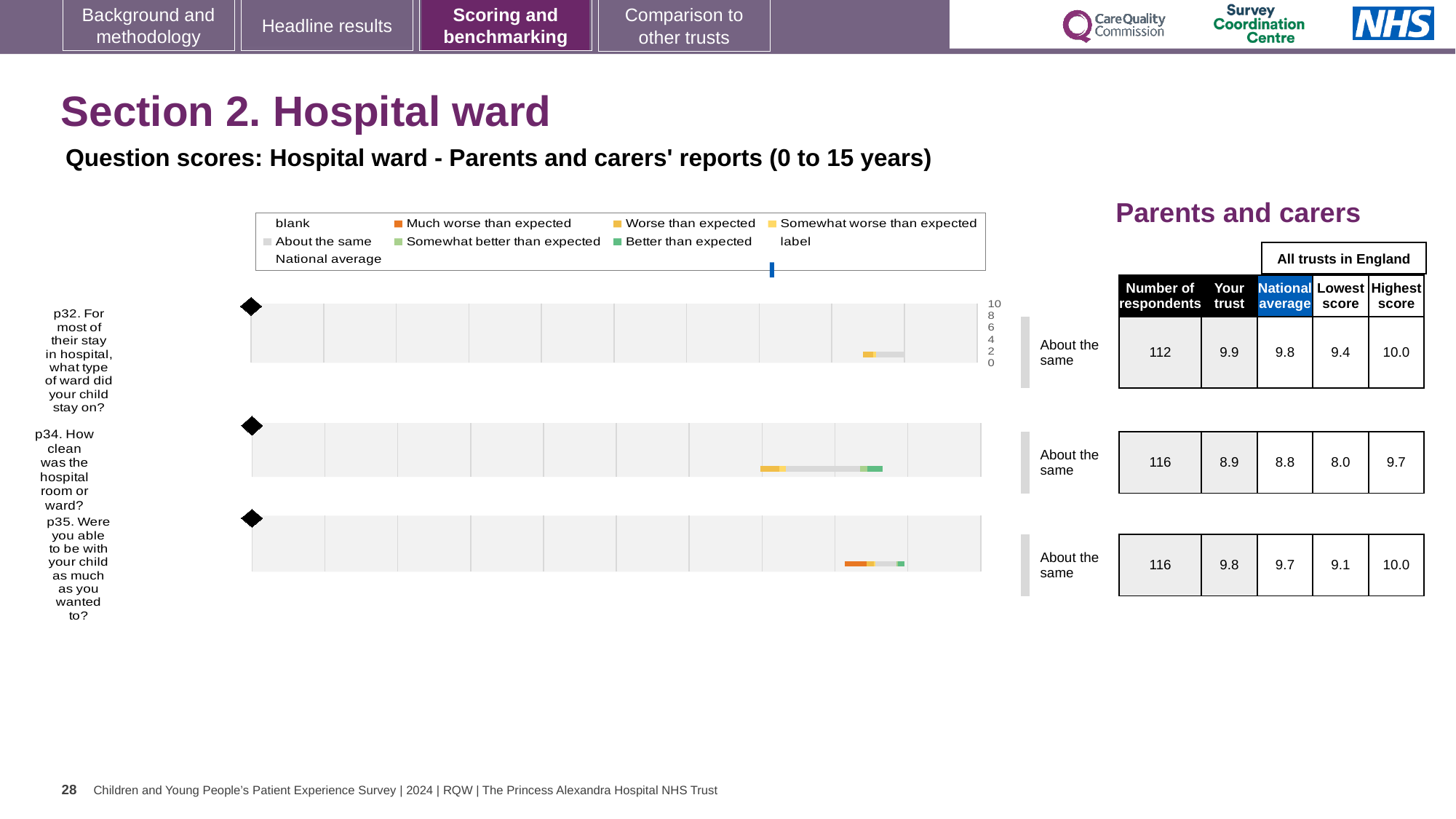
For p35, which is larger: the 'Your trust' score or the national average? Your trust For p35 (Were you able to be with your child as much as you wanted to?), how many respondents are there? 116 For p34 (How clean was the hospital room or ward?), what is the 'Your trust' score? 8.9 For p32 (what type of ward did your child stay on?), what is the national average score? 9.8 Which question has the lowest 'Your trust' score? p34 In the legend, what colour represents 'Better than expected'? green What kind of chart is used for each question on the slide? bar chart For p34, what is the difference between the highest score and the lowest score? 1.7 How many questions (charts) are plotted on the slide? 3 Which question has the highest 'Your trust' score? p32 For p34, what is the highest score among all trusts in England? 9.7 In the legend, what colour represents 'Much worse than expected'? orange